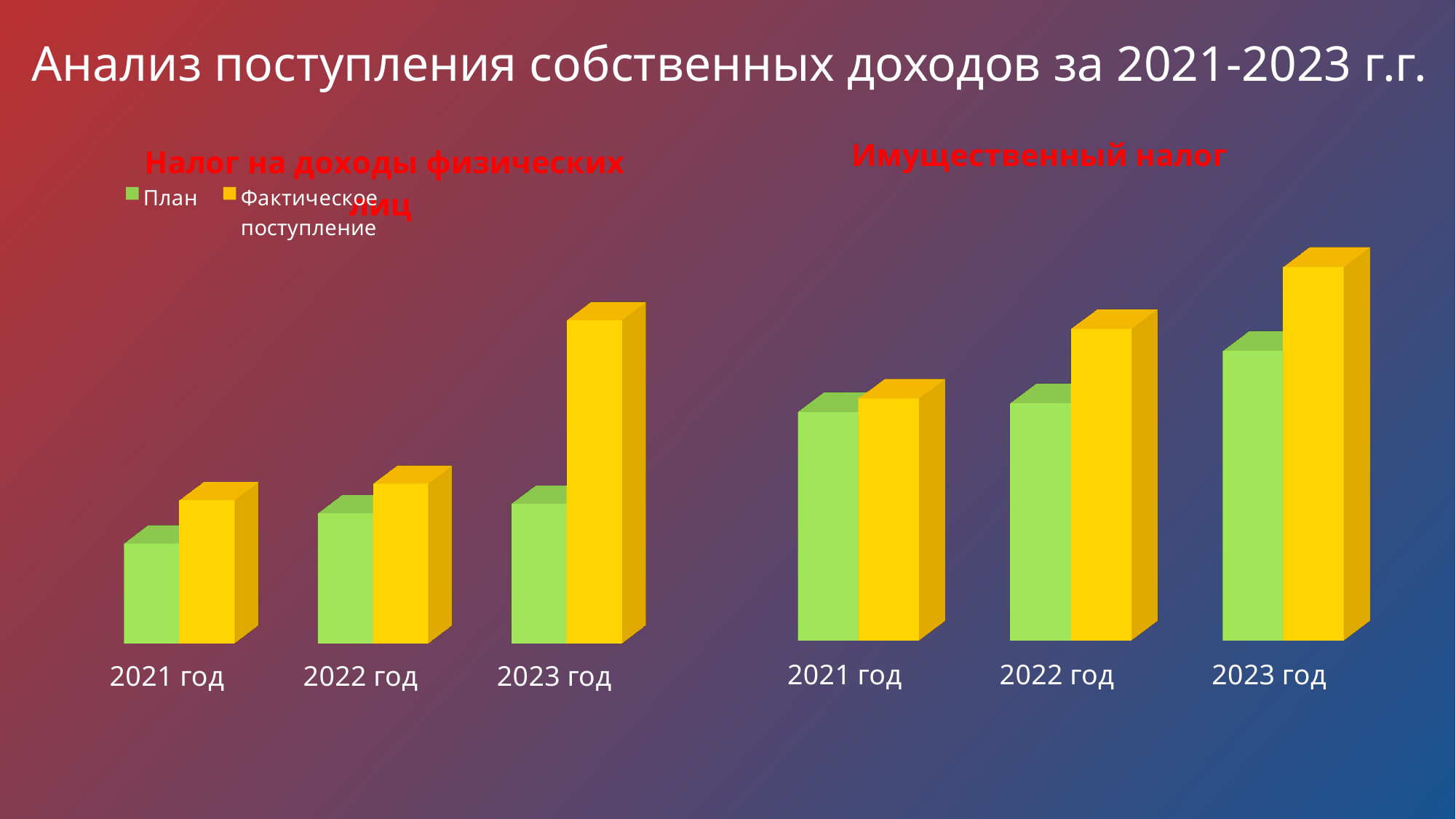
What kind of chart is the left chart titled "Налог на доходы физических лиц"? bar chart In the left chart "Налог на доходы физических лиц", for 2023 год, which is larger: План or Фактическое поступление? Фактическое поступление In the left chart "Налог на доходы физических лиц", do the Фактическое поступление values rise or fall from 2021 год to 2023 год? rise What colour are the План bars in the left chart? green In the right chart "Имущественный налог", do the План values rise or fall from 2021 год to 2023 год? rise How many year categories are shown on the x axis of the right chart titled "Имущественный налог"? 3 In the left chart "Налог на доходы физических лиц", which year has the tallest Фактическое поступление bar? 2023 год In the right chart "Имущественный налог", which year has the shortest План bar? 2021 год In the right chart "Имущественный налог", which year has the tallest Фактическое поступление bar? 2023 год What are the two series named in the legend of the left chart? План and Фактическое поступление How many series does the legend of the left chart list? 2 In the left chart "Налог на доходы физических лиц", which year has the shortest План bar? 2021 год